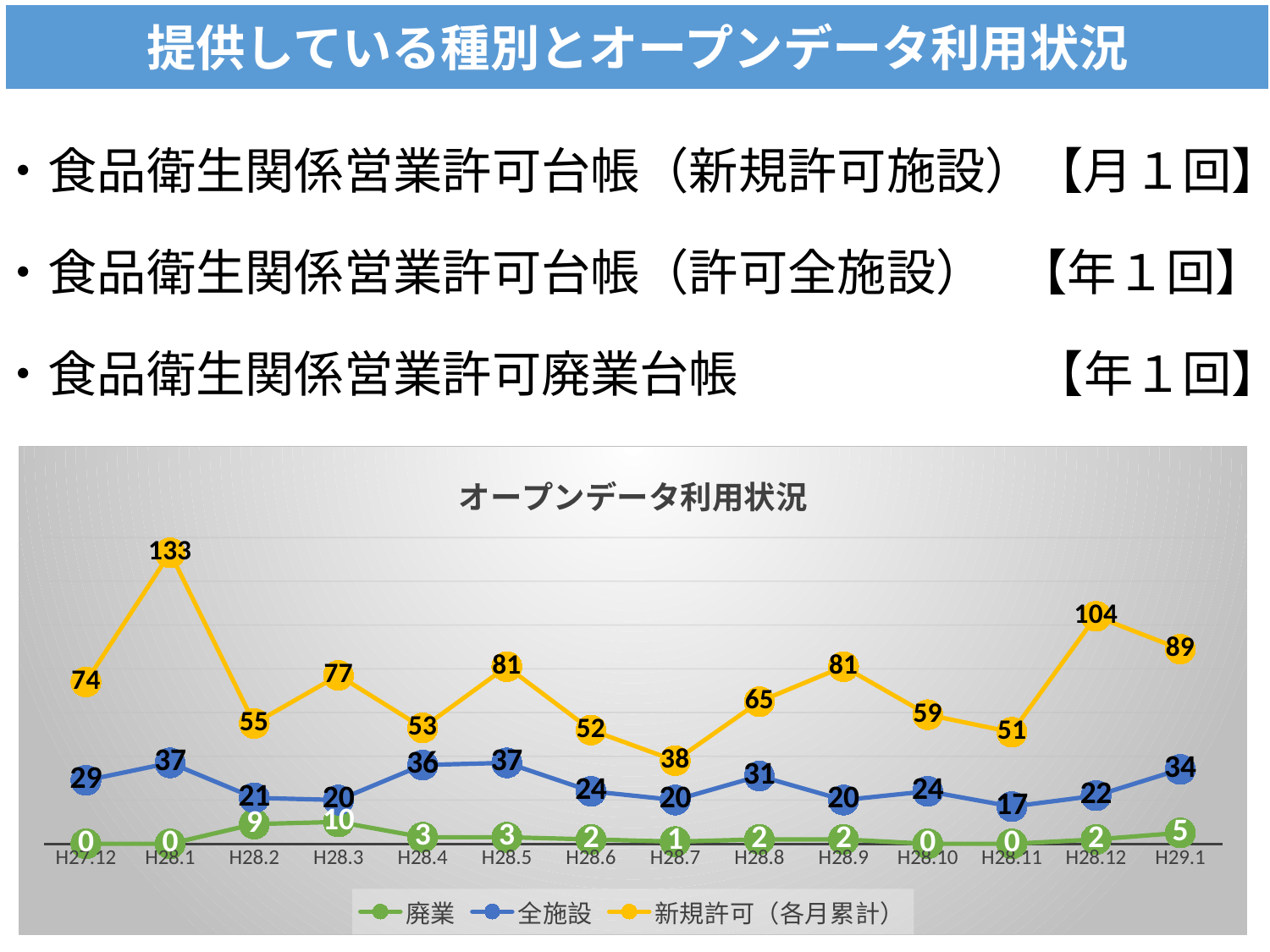
At which month is 新規許可（各月累計） lowest? H28.7 Which is larger, 全施設 at H28.8 or 全施設 at H28.9? H28.8 What is the value of 新規許可（各月累計） at H28.1? 133 What is the value of 廃業 at H28.3? 10 What is the value of 全施設 at H28.5? 37 What is the difference between 新規許可（各月累計） at H28.12 and at H29.1? 15 Does 新規許可（各月累計） rise or fall from H28.9 to H28.11? fall What type of chart is shown on the slide? line chart How many series does the legend list? 3 How many points are plotted along the x axis for each series? 14 At which month is 新規許可（各月累計） highest? H28.1 What is the title of the chart? オープンデータ利用状況